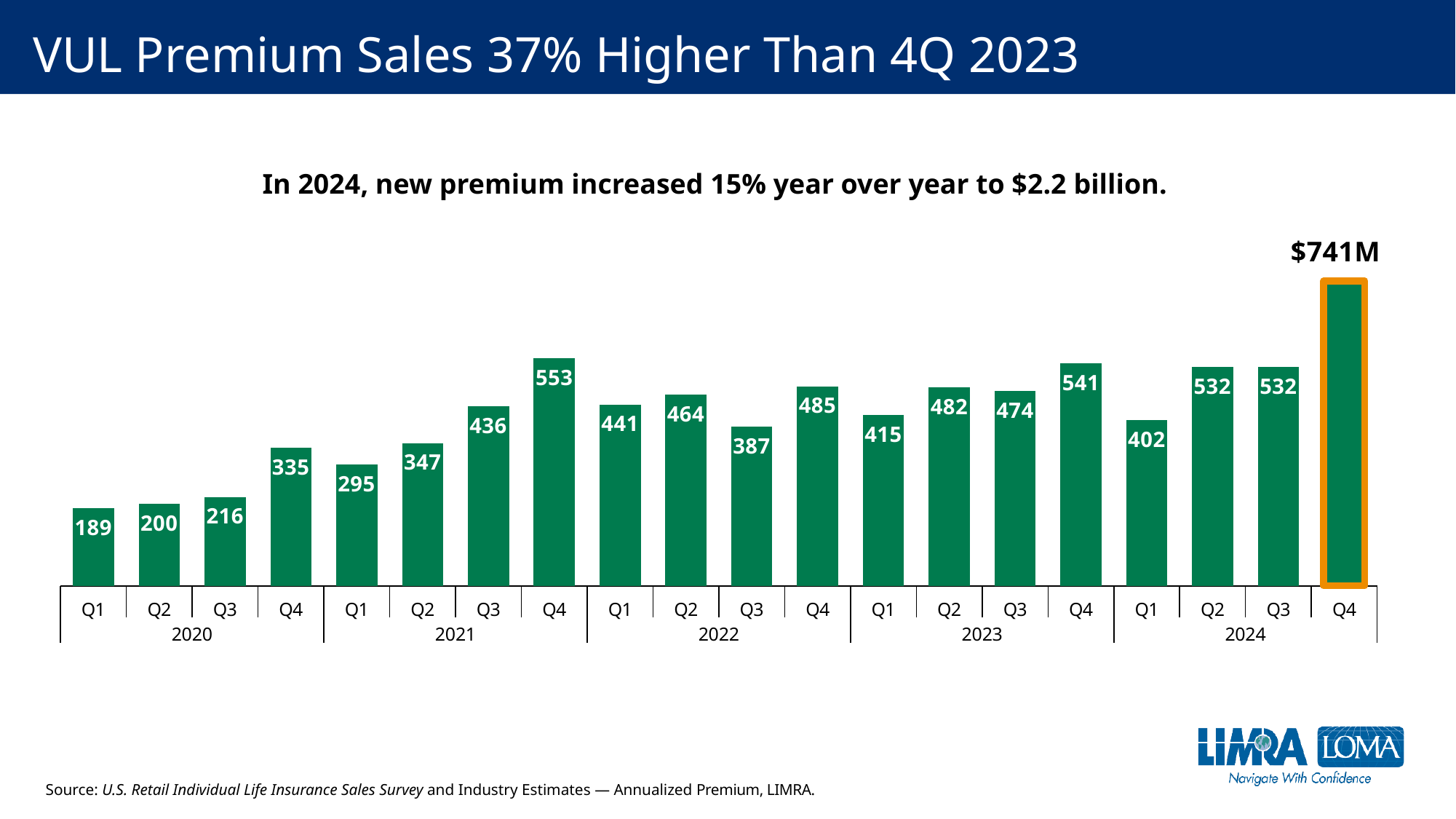
What is the value for Q4 2021? 553 How many bars are plotted on the chart? 20 What kind of chart is shown? Bar chart Which quarter has the lowest value? Q1 2020 Do the values rise or fall across the four quarters of 2020? Rise What is the value for Q3 2022? 387 What is the value for Q4 2024? $741M What is the difference between Q4 2023 and Q3 2023? 67 What is the title of the slide? VUL Premium Sales 37% Higher Than 4Q 2023 What is the value for Q1 2020? 189 Which is larger, Q2 2022 or Q2 2023? Q2 2023 Which quarter has the highest value? Q4 2024